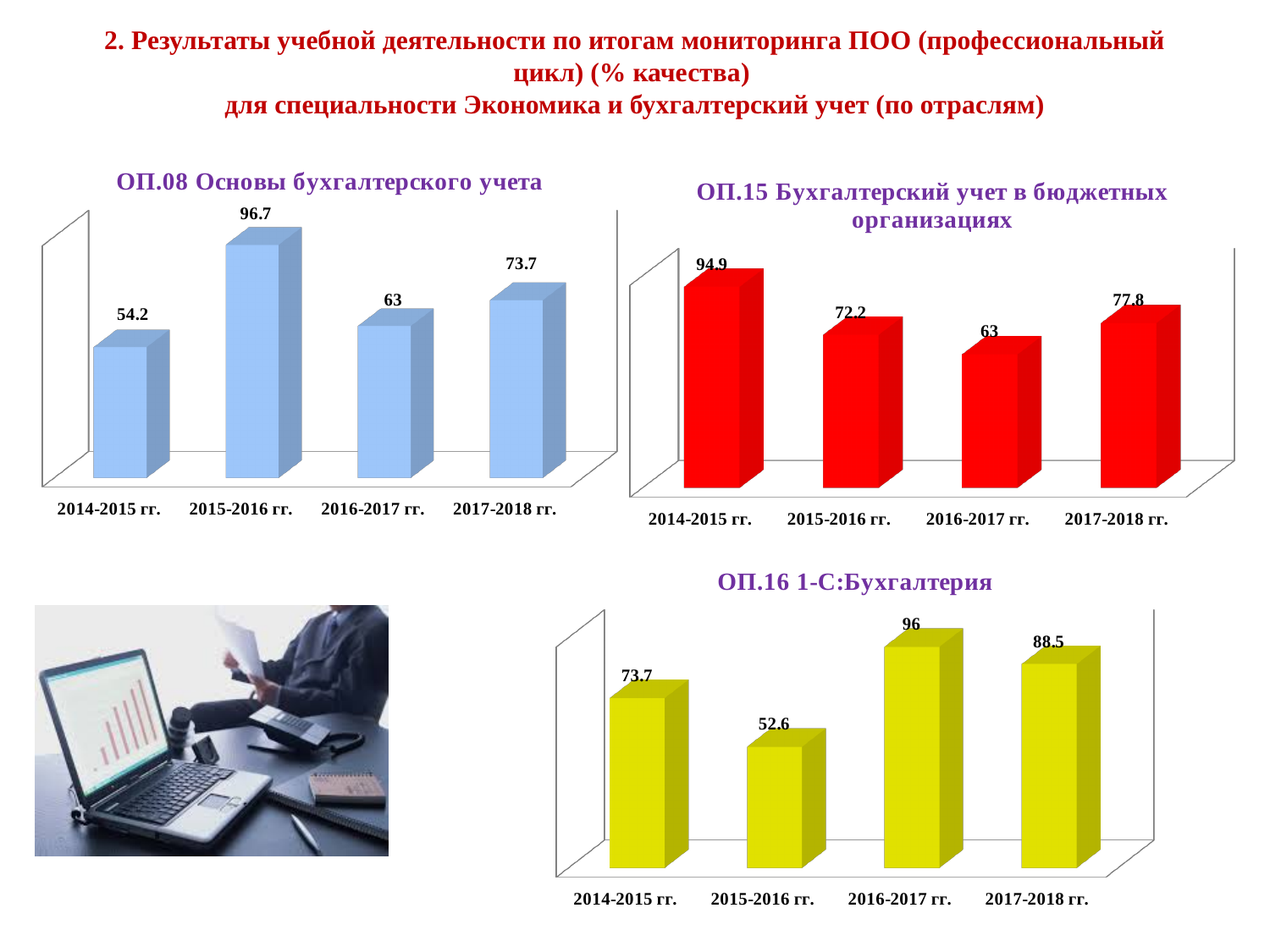
In the chart titled "ОП.16 1-С:Бухгалтерия", what is the value for 2015-2016 гг.? 52.6 What type of chart is the one titled "ОП.08 Основы бухгалтерского учета"? Bar chart In the chart titled "ОП.16 1-С:Бухгалтерия", which year has the highest value? 2016-2017 гг. What colour are the bars in the chart titled "ОП.15 Бухгалтерский учет в бюджетных организациях"? Red In the chart titled "ОП.08 Основы бухгалтерского учета", which year has the lowest value? 2014-2015 гг. In the chart titled "ОП.15 Бухгалтерский учет в бюджетных организациях", which is larger: the value for 2015-2016 гг. or 2017-2018 гг.? 2017-2018 гг. In the chart titled "ОП.08 Основы бухгалтерского учета", what is the value for 2015-2016 гг.? 96.7 In the chart titled "ОП.15 Бухгалтерский учет в бюджетных организациях", which year has the lowest value? 2016-2017 гг. In the chart titled "ОП.08 Основы бухгалтерского учета", what is the difference between the values for 2015-2016 гг. and 2016-2017 гг.? 33.7 In the chart titled "ОП.15 Бухгалтерский учет в бюджетных организациях", what is the value for 2014-2015 гг.? 94.9 In the chart titled "ОП.16 1-С:Бухгалтерия", what is the difference between the values for 2016-2017 гг. and 2017-2018 гг.? 7.5 How many categories are shown in the chart titled "ОП.16 1-С:Бухгалтерия"? 4